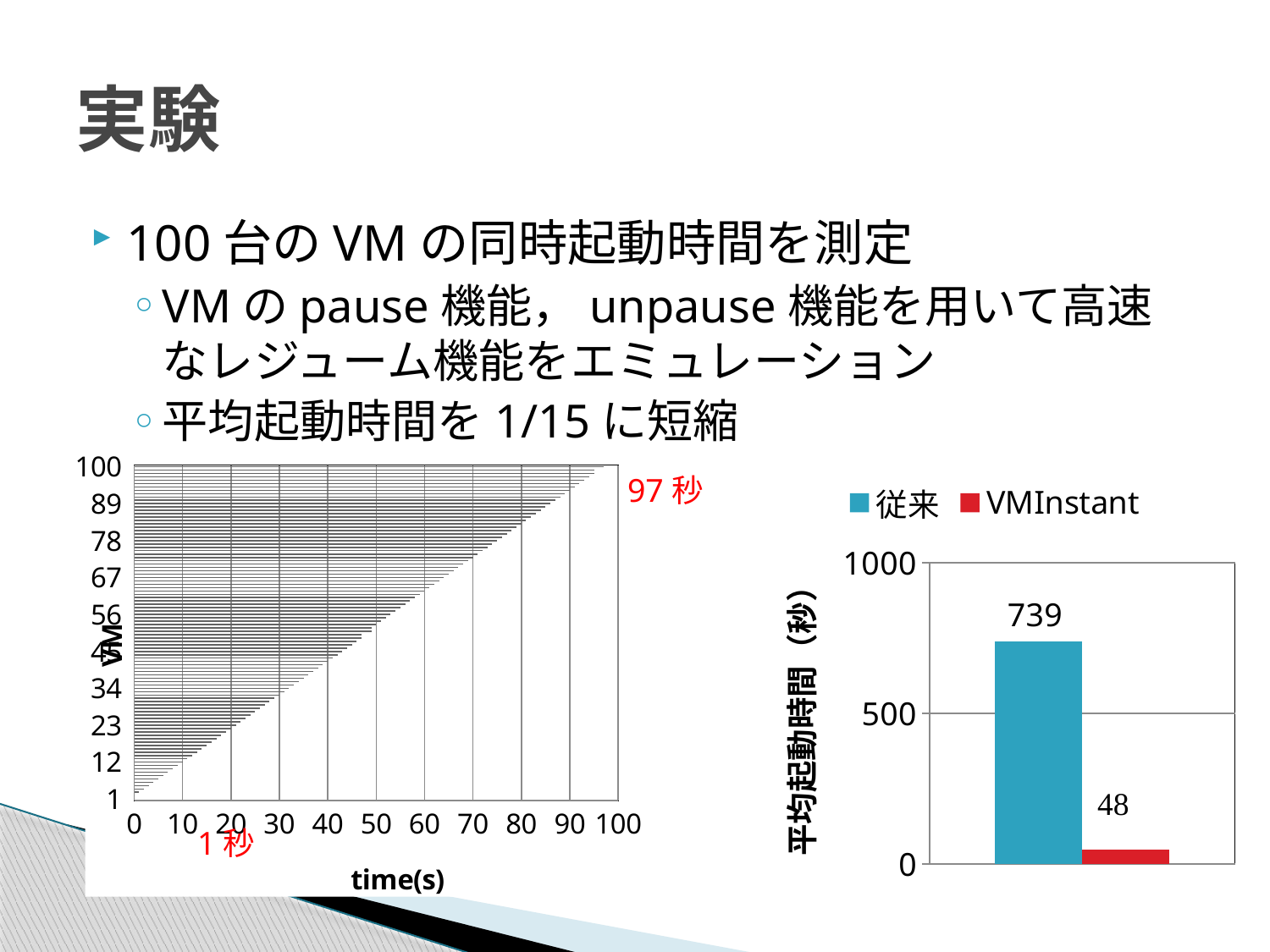
What kind of chart is the right chart? bar chart On the right chart, is the value for VMInstant greater or less than 500? less On the right chart, is the value for 従来 greater or less than 500? greater On the right chart, what is the difference between the 従来 value and the VMInstant value? 691 On the right chart, how many series does the legend list? 2 On the right chart, which series has the higher value, 従来 or VMInstant? 従来 On the right chart, what is the value for 従来? 739 On the right chart, what is the value for VMInstant? 48 What kind of chart is the left chart? bar chart On the left chart, what is the highest value shown on the x axis? 100 On the right chart, what is the y-axis title? 平均起動時間（秒） On the left chart, what is the x-axis title? time(s)